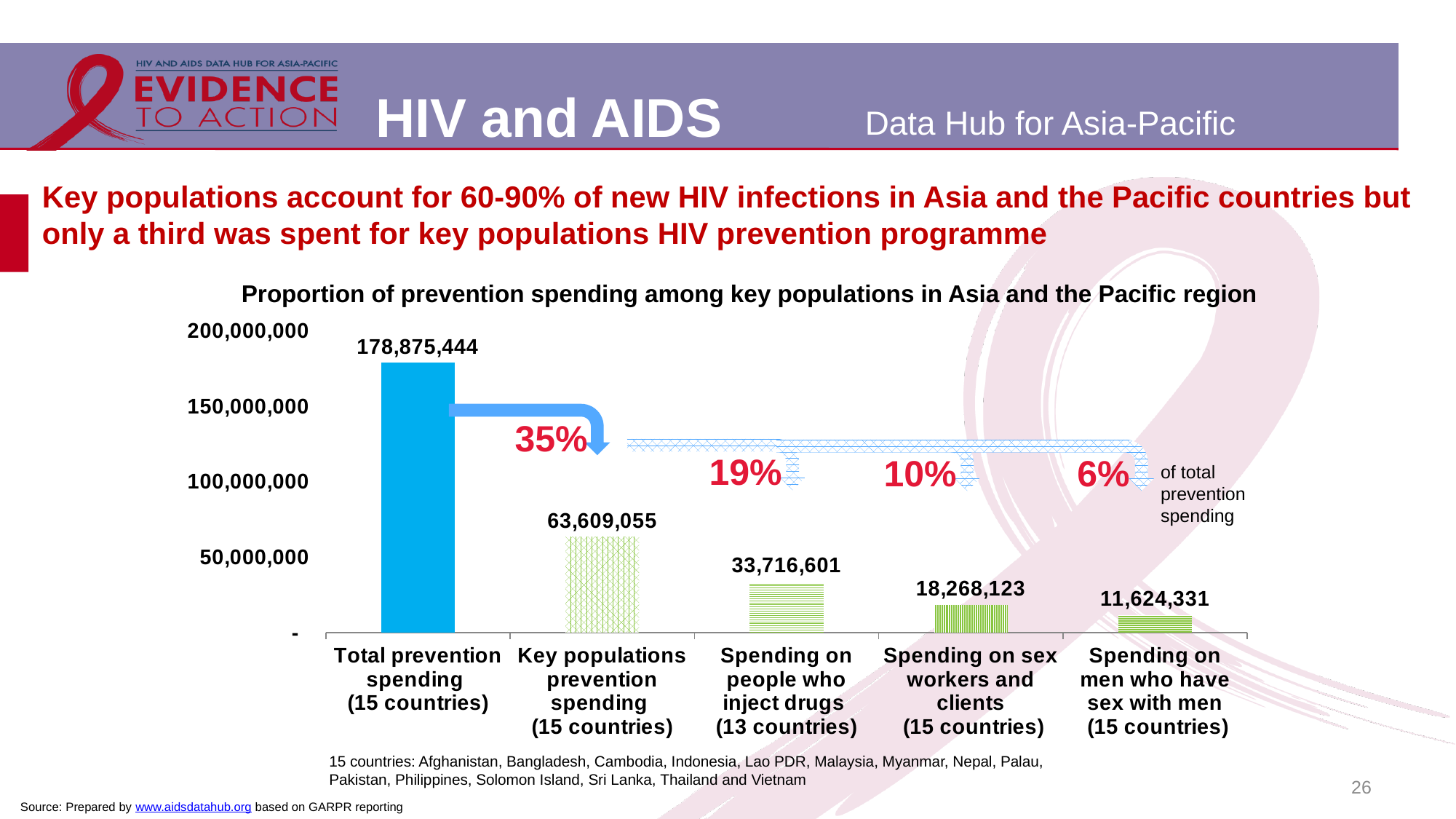
What is the value for Total prevention spending (15 countries)? 178,875,444 What percentage of total prevention spending is annotated for Spending on sex workers and clients? 10% What is the difference between Total prevention spending and Key populations prevention spending? 115,266,389 How many categories are shown on the x axis? 5 What is the value for Spending on people who inject drugs (13 countries)? 33,716,601 What is the value for Spending on men who have sex with men (15 countries)? 11,624,331 Which category has the lowest value? Spending on men who have sex with men (15 countries) Which category has the highest value? Total prevention spending (15 countries) What kind of chart is this? Bar chart Which is larger: Spending on people who inject drugs or Spending on sex workers and clients? Spending on people who inject drugs What is the difference between Spending on sex workers and clients and Spending on men who have sex with men? 6,643,792 What is the value for Key populations prevention spending (15 countries)? 63,609,055